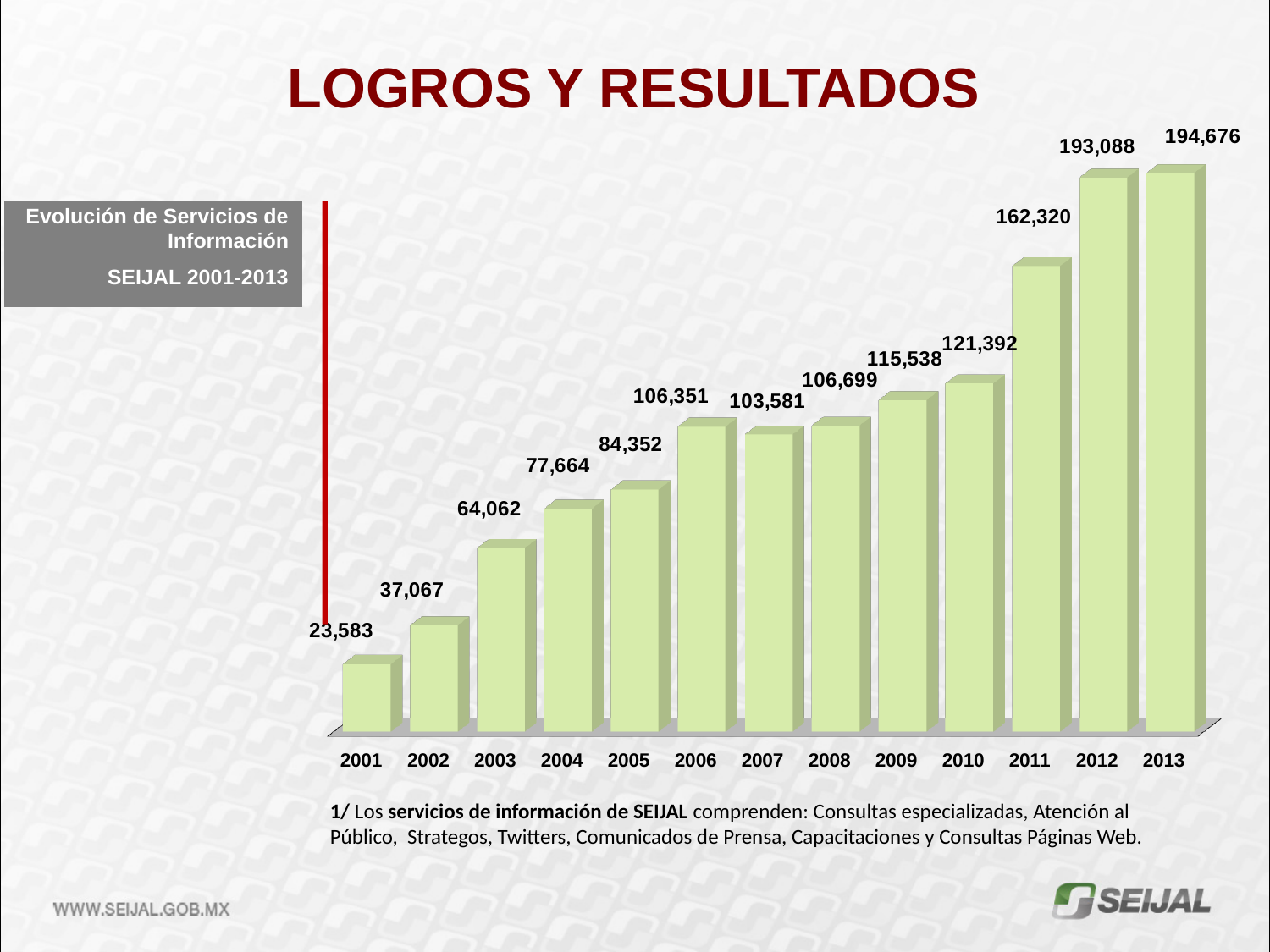
What is the value for 2007? 103,581 Which is larger, the value for 2003 or the value for 2005? 2005 What is the difference between the values for 2013 and 2012? 1,588 Which is larger, the value for 2006 or the value for 2007? 2006 What is the value for 2001? 23,583 What is the difference between the values for 2011 and 2010? 40,928 How many years are shown on the x axis? 13 What is the value for 2011? 162,320 Do the values generally rise or fall from 2001 to 2013? Rise Which year has the highest value? 2013 Which year has the lowest value? 2001 What kind of chart is shown on the slide? Bar chart